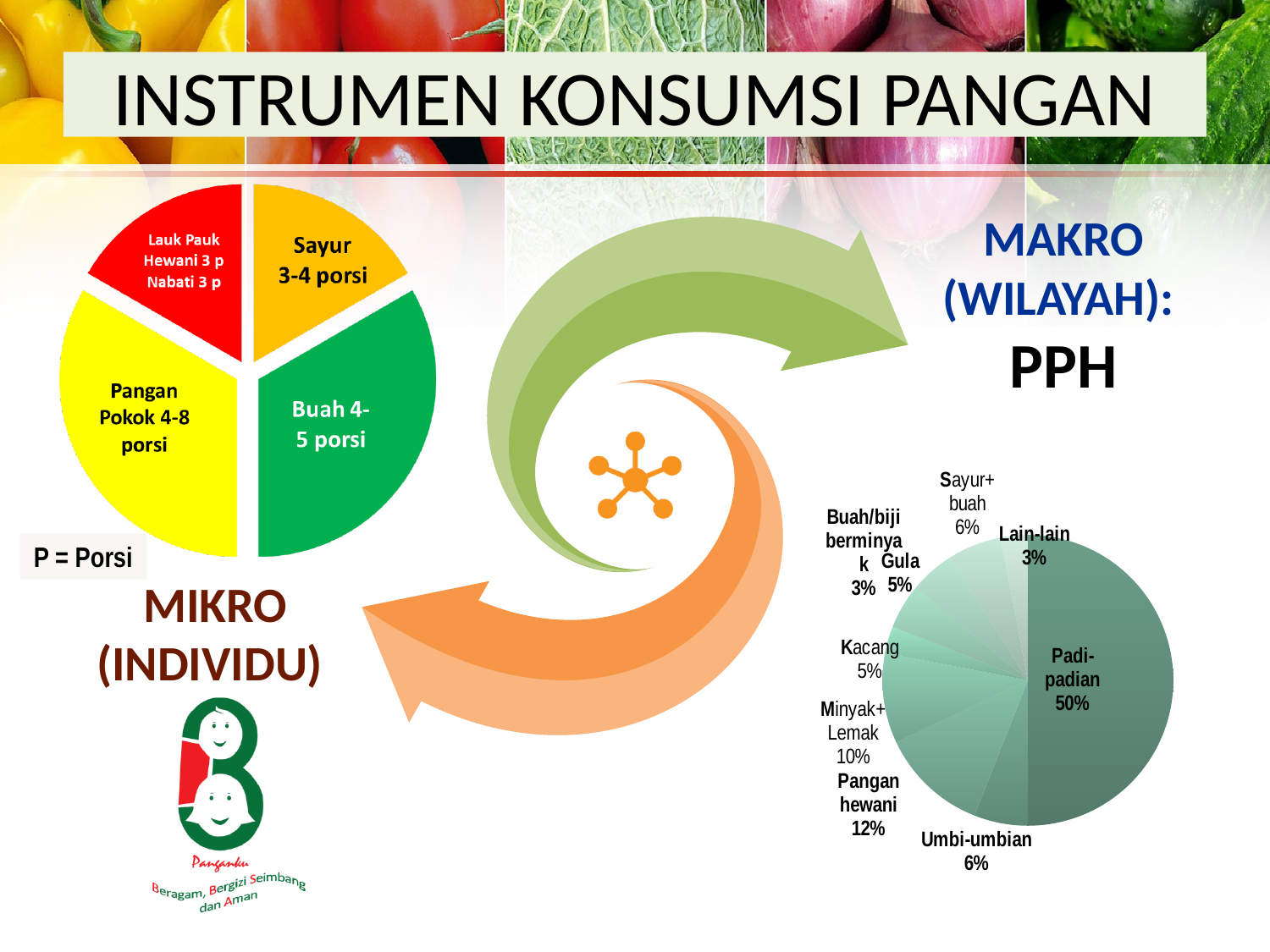
In the PPH pie chart on the right, which category has the largest share? Padi-padian What kind of chart is the PPH chart on the right of the slide? Pie chart In the PPH pie chart on the right, what share does Padi-padian have? 50% In the PPH pie chart on the right, what is the difference between the shares of Padi-padian and Pangan hewani? 38% How many slices does the PPH pie chart on the right have? 9 In the PPH pie chart on the right, which is larger: Umbi-umbian or Minyak+Lemak? Minyak+Lemak In the PPH pie chart on the right, what share do Gula and Kacang have together? 10% In the PPH pie chart on the right, what share does Minyak+Lemak have? 10% In the PPH pie chart on the right, what share does Pangan hewani have? 12% In the MIKRO (INDIVIDU) pie chart on the left, how many portions are shown for Pangan Pokok? 4-8 porsi How many slices does the MIKRO (INDIVIDU) pie chart on the left have? 4 In the MIKRO (INDIVIDU) pie chart on the left, how many portions are shown for Sayur? 3-4 porsi